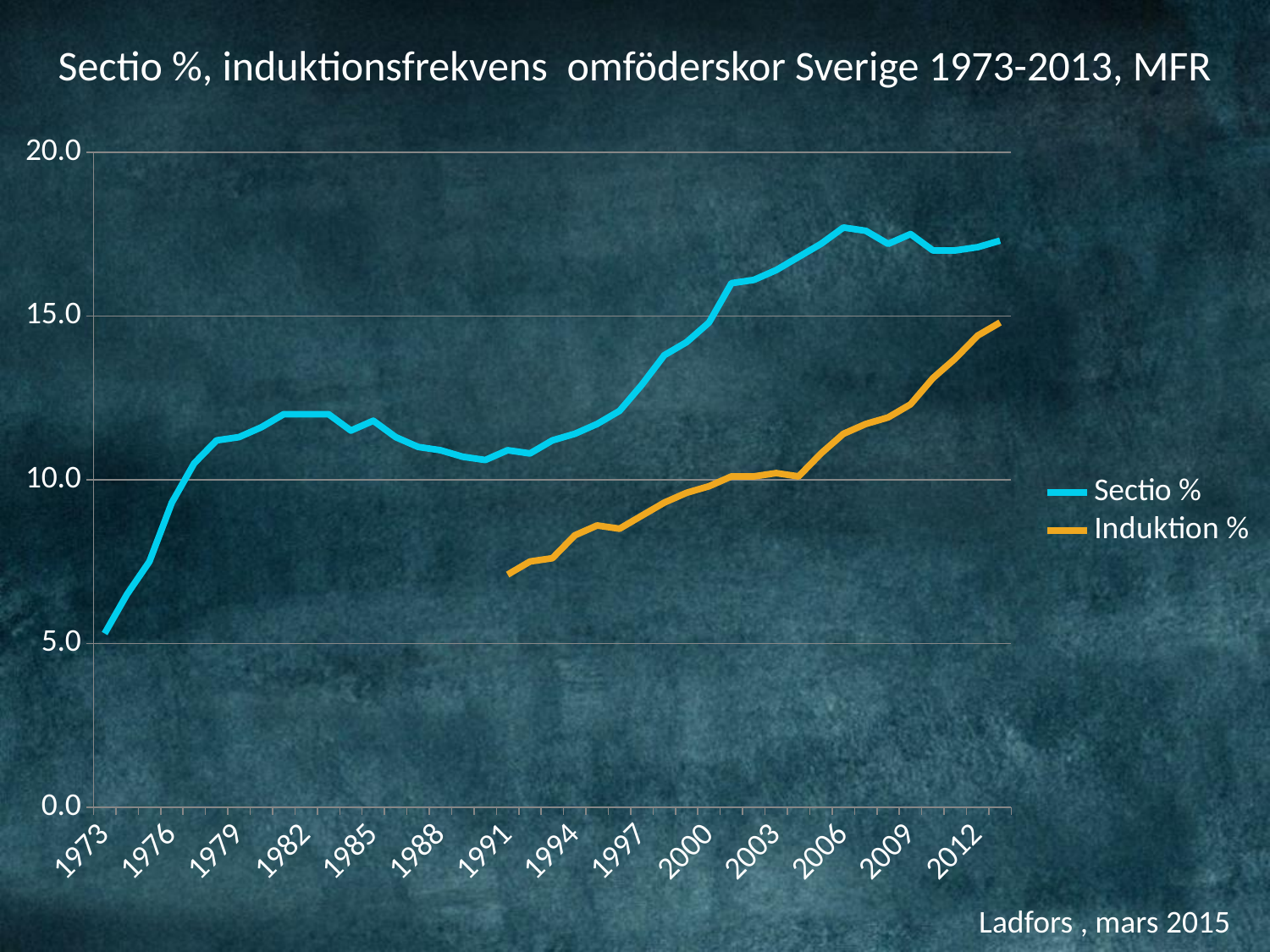
Does the Induktion % line rise or fall from 1991 to 2013? rise In 2013, which series has the higher value, Sectio % or Induktion %? Sectio % Does the Sectio % line rise or fall from 1973 to 1982? rise Is the value for Sectio % in 2006 greater or less than 15.0? greater Is the value for Sectio % in 2003 greater or less than 15.0? greater Is the value for Induktion % in 1991 greater or less than 10.0? less What kind of chart is shown on the slide? line chart What are the two series named in the legend? Sectio % and Induktion % What is the title of the chart? Sectio %, induktionsfrekvens omföderskor Sverige 1973-2013, MFR How many series does the legend list? 2